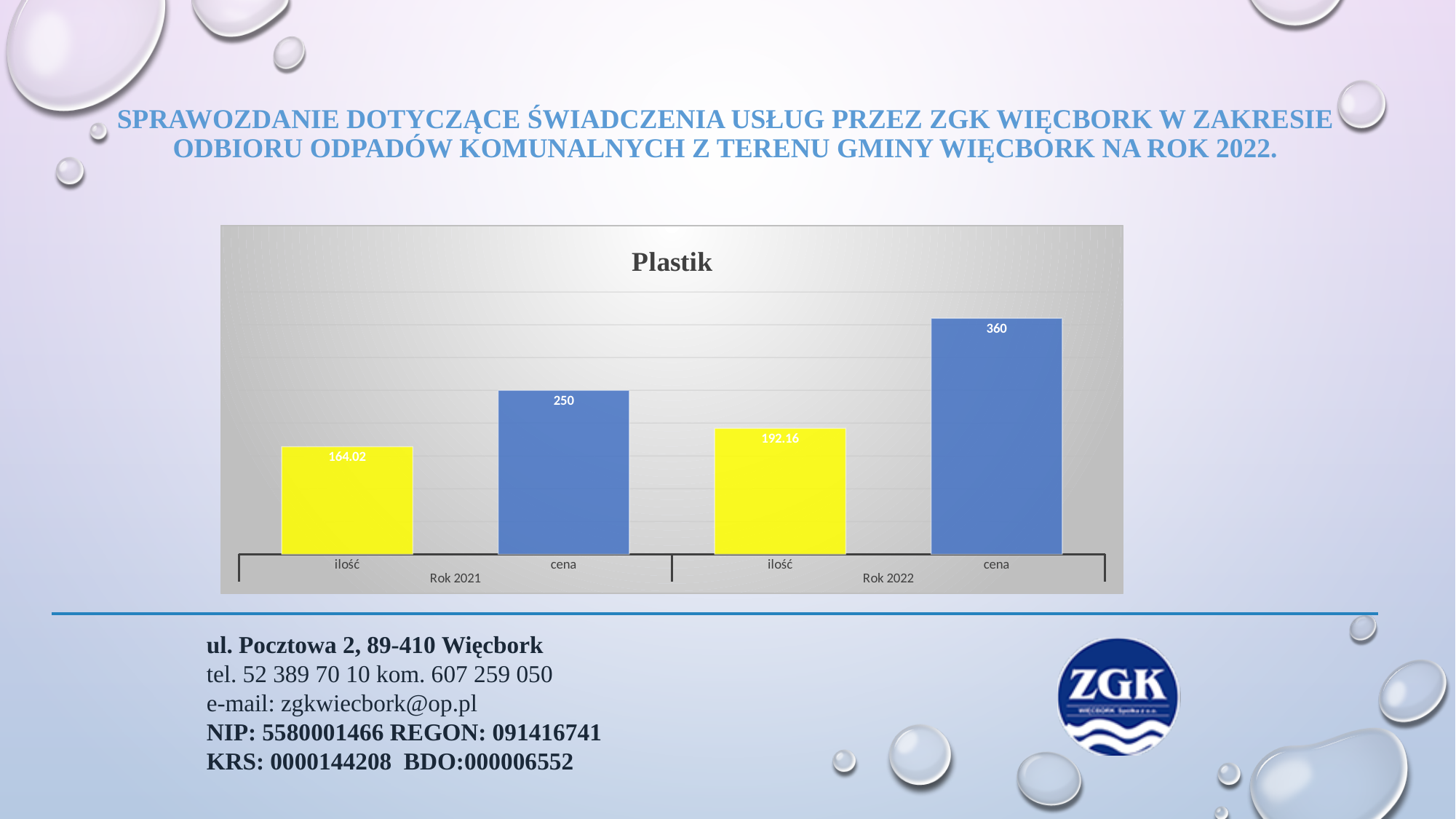
What is the title of the chart? Plastik What is the value of cena for Rok 2021? 250 What is the value of ilość for Rok 2021? 164.02 What type of chart is shown on the slide? bar chart Which bar has the highest value? cena, Rok 2022 What is the difference between cena for Rok 2022 and cena for Rok 2021? 110 What is the value of ilość for Rok 2022? 192.16 What is the value of cena for Rok 2022? 360 Which is larger: ilość for Rok 2022 or cena for Rok 2021? cena for Rok 2021 What is the difference between ilość for Rok 2022 and ilość for Rok 2021? 28.14 How many bars are plotted in the chart? 4 Which bar has the lowest value? ilość, Rok 2021